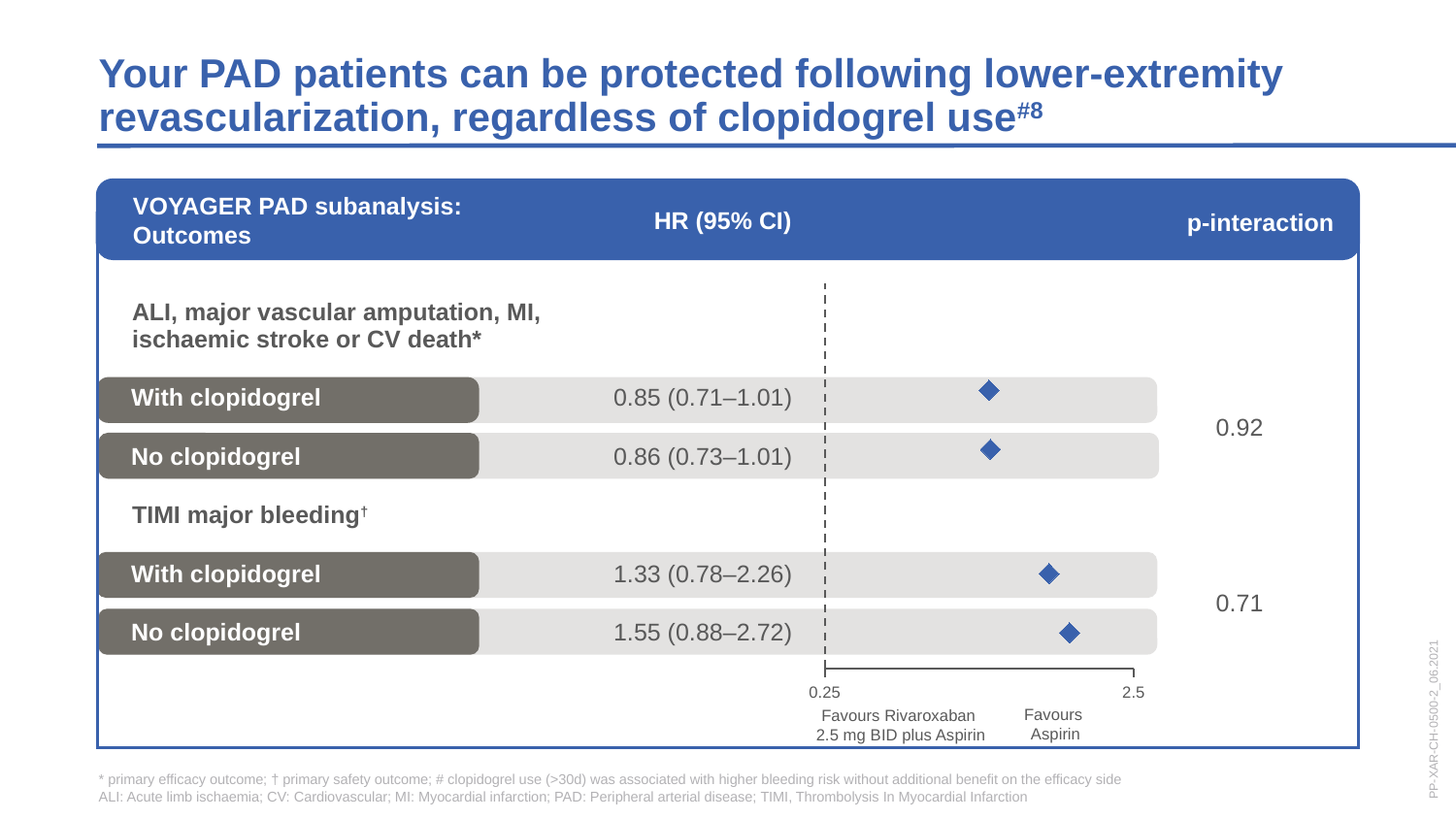
What are the two labels shown under the x axis indicating which treatment is favoured? Favours Rivaroxaban 2.5 mg BID plus Aspirin; Favours Aspirin What is the difference between the TIMI major bleeding hazard ratios for no clopidogrel and with clopidogrel? 0.22 For TIMI major bleeding, is the hazard ratio larger with clopidogrel or with no clopidogrel? No clopidogrel How many hazard ratio rows are plotted in the chart? 4 What is the p-interaction value for the TIMI major bleeding outcome? 0.71 What is the p-interaction value for the ALI, major vascular amputation, MI, ischaemic stroke or CV death outcome? 0.92 What is the HR (95% CI) for the ALI, major vascular amputation, MI, ischaemic stroke or CV death outcome with no clopidogrel? 0.86 (0.73–1.01) What is the HR (95% CI) for TIMI major bleeding with clopidogrel? 1.33 (0.78–2.26) Which row has the lowest hazard ratio point estimate? ALI, major vascular amputation, MI, ischaemic stroke or CV death, With clopidogrel What is the HR (95% CI) for the ALI, major vascular amputation, MI, ischaemic stroke or CV death outcome with clopidogrel? 0.85 (0.71–1.01) Which row has the highest hazard ratio point estimate? TIMI major bleeding, No clopidogrel What is the HR (95% CI) for TIMI major bleeding with no clopidogrel? 1.55 (0.88–2.72)